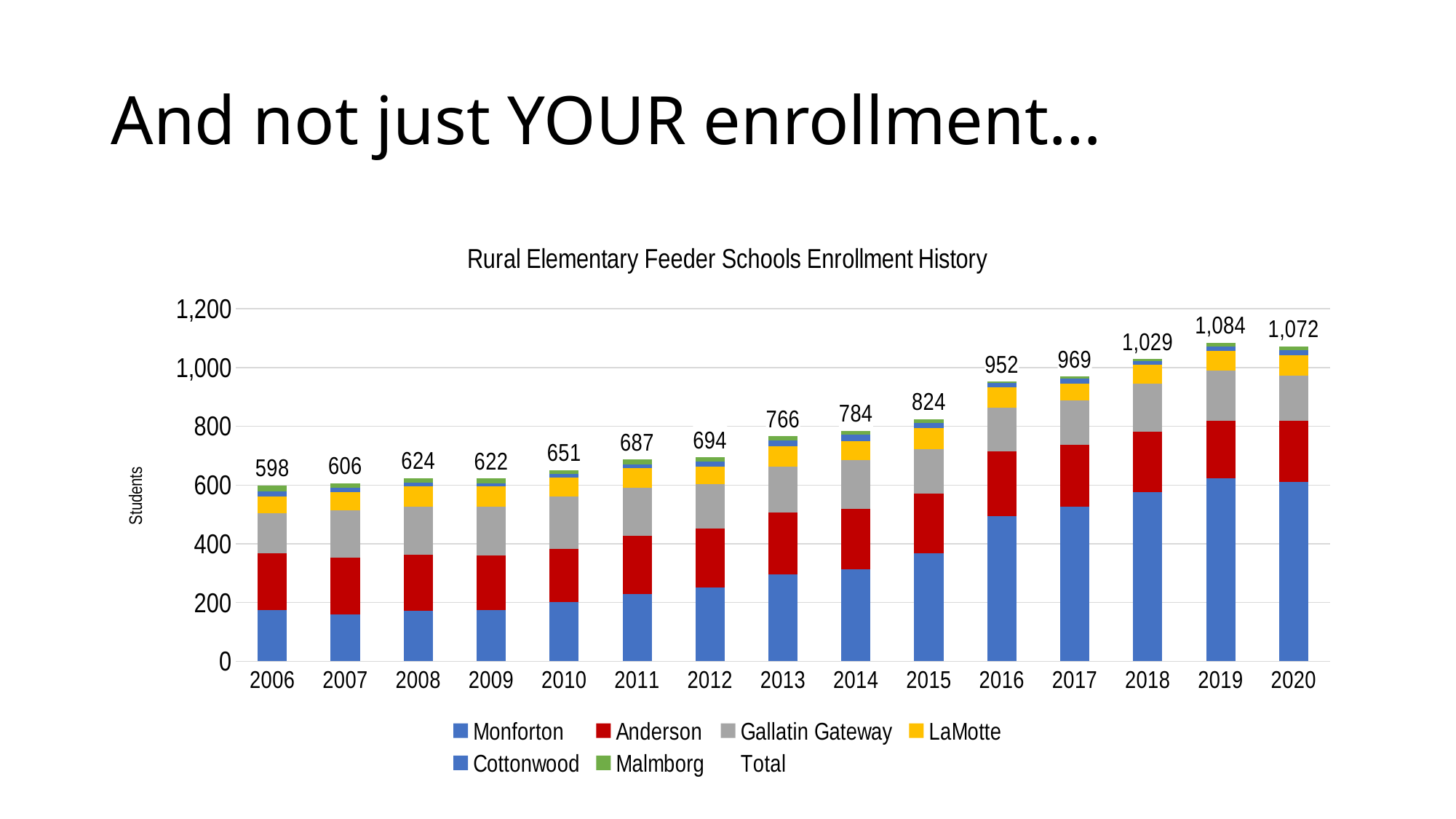
How many entries does the legend list? 7 What is the title of the chart? Rural Elementary Feeder Schools Enrollment History Which year has the highest total enrollment? 2019 What kind of chart is shown on the slide? Stacked bar chart Is the value for Monforton in 2019 greater or less than 400? greater Which year has the larger total enrollment, 2019 or 2020? 2019 Which year has the lowest total enrollment? 2006 What is the difference between the total enrollment in 2020 and in 2006? 474 What is the total enrollment shown for 2016? 952 What is the difference between the total enrollment in 2019 and in 2018? 55 What is the total enrollment shown for 2006? 598 How many years are shown on the x axis? 15